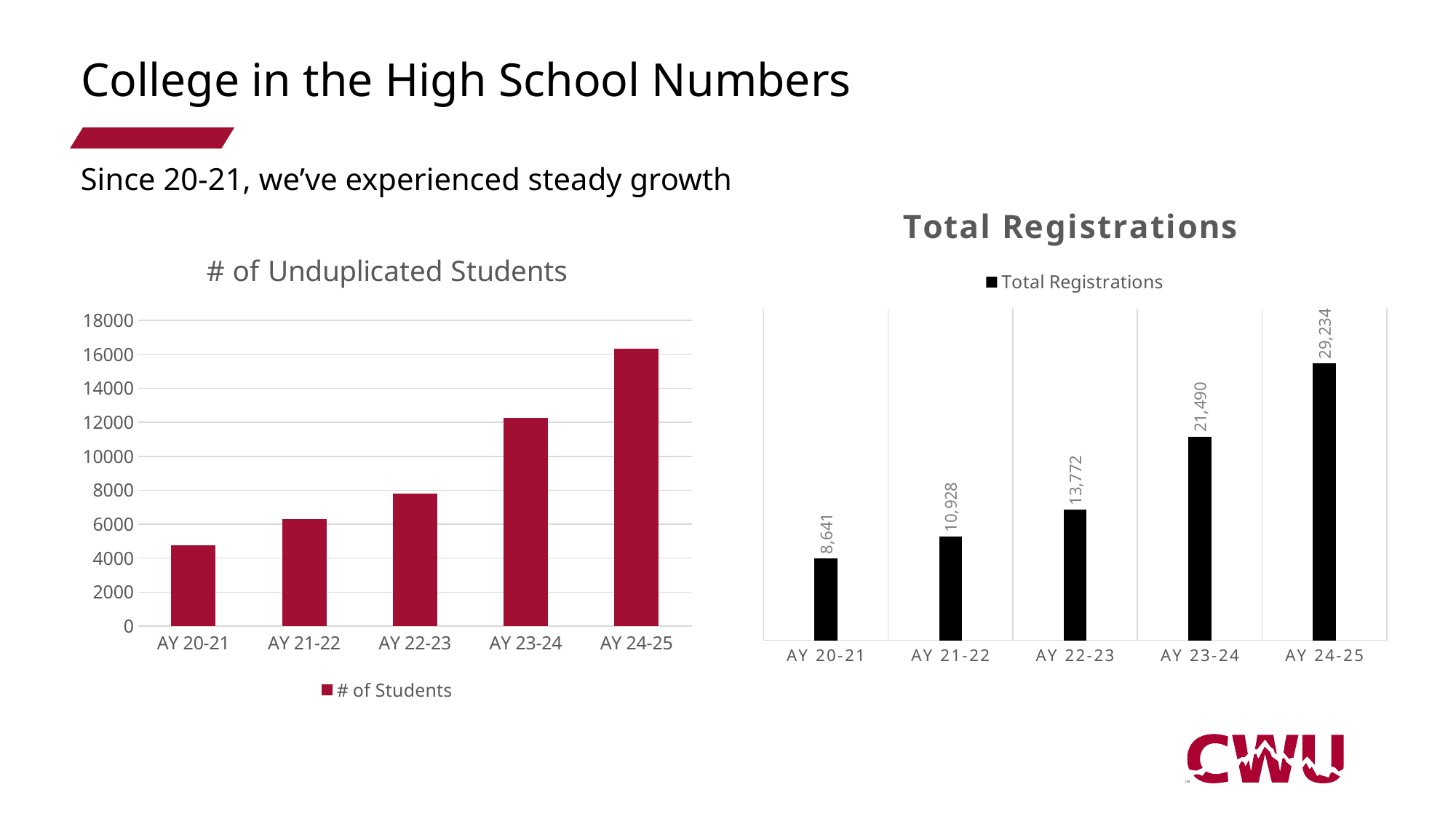
In the "Total Registrations" chart, what is the difference between AY 23-24 and AY 22-23? 7,718 In the "# of Unduplicated Students" chart, which is larger, AY 23-24 or AY 21-22? AY 23-24 In the "# of Unduplicated Students" chart, which academic year has the lowest value? AY 20-21 In the "# of Unduplicated Students" chart, is the value for AY 24-25 greater or less than 16000? greater In the "Total Registrations" chart, what is the value for AY 20-21? 8,641 In the "Total Registrations" chart, what is the difference between AY 21-22 and AY 20-21? 2,287 In the "Total Registrations" chart, what is the value for AY 22-23? 13,772 In the "Total Registrations" chart, which academic year has the highest value? AY 24-25 How many academic years are shown in the "Total Registrations" chart? 5 In the "# of Unduplicated Students" chart, do the values rise or fall from AY 20-21 to AY 24-25? rise In the "Total Registrations" chart, what is the value for AY 24-25? 29,234